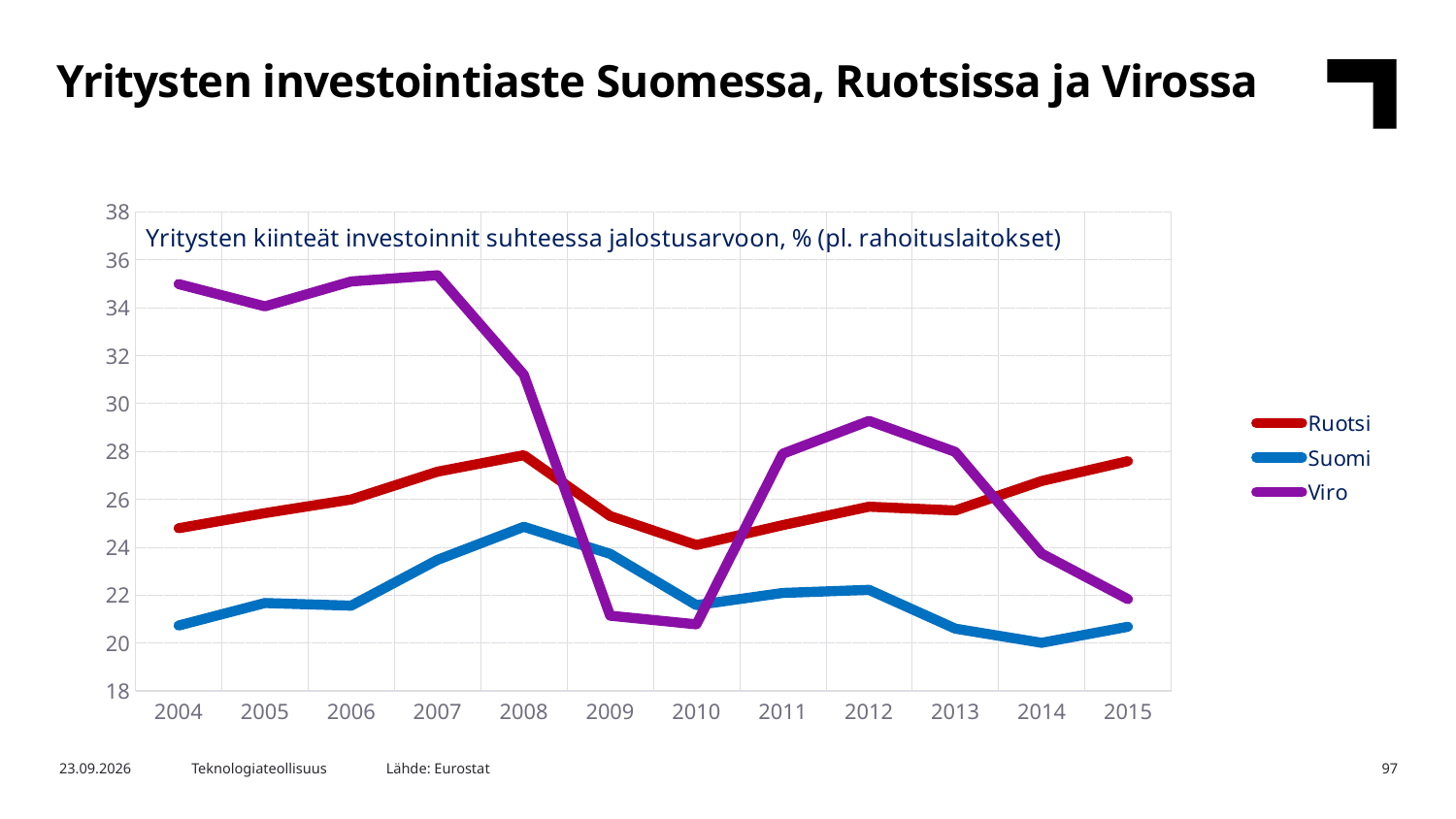
How many series does the legend list? 3 What kind of chart is shown on the slide? line chart In 2012, which is larger, the value for Viro or the value for Ruotsi? Viro Which series has the highest value in 2004? Viro Which series has the lowest value in 2015? Suomi Is the value for Viro in 2004 greater or less than 32? greater How many years are shown on the x axis? 12 In 2010, which is larger, the value for Ruotsi or the value for Viro? Ruotsi Is the value for Ruotsi in 2008 greater or less than 26? greater What colour is the line for Viro? purple Is the value for Suomi in 2014 greater or less than 22? less Does the value for Viro rise or fall from 2007 to 2010? fall